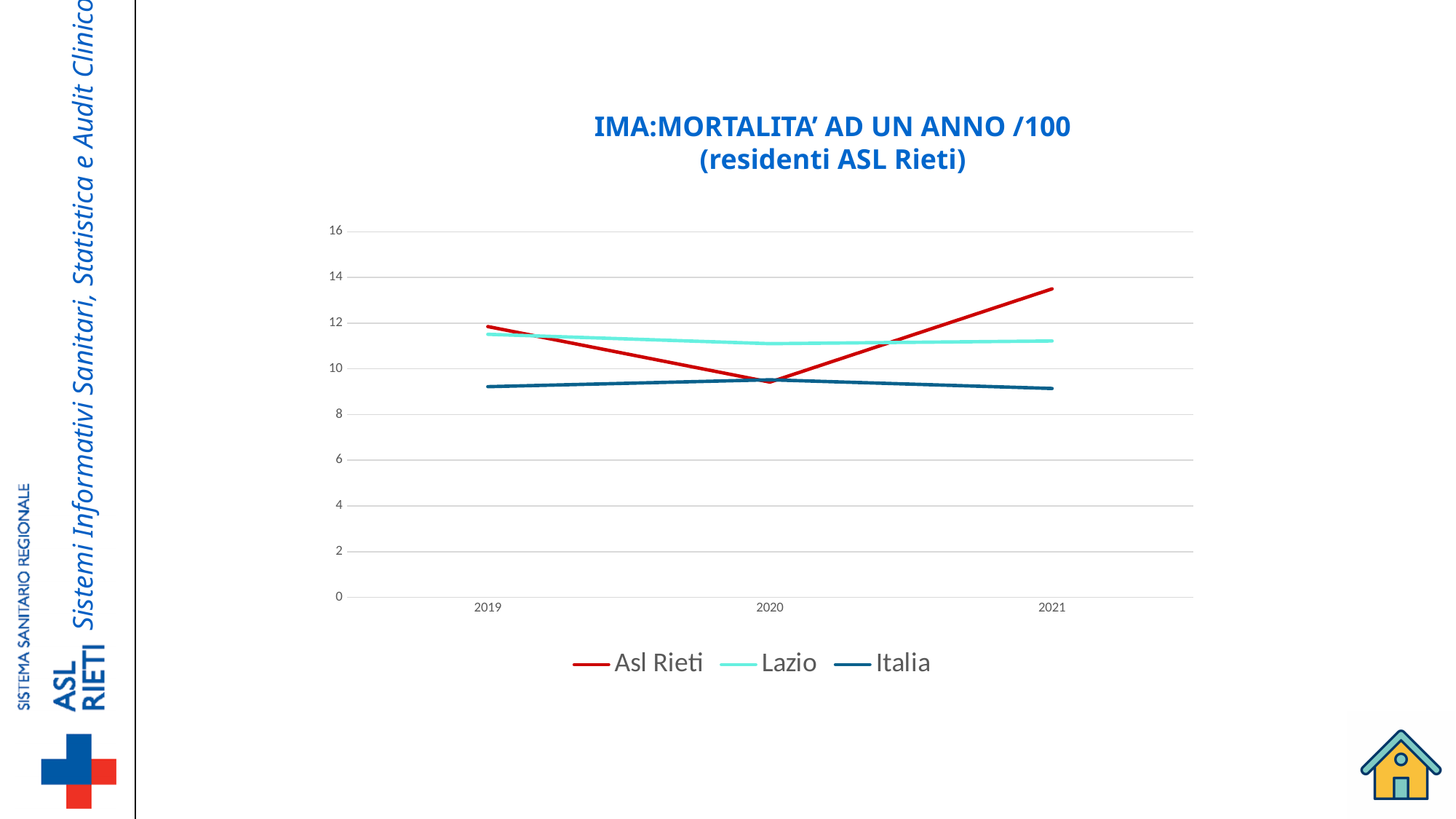
Does the Asl Rieti line rise or fall from 2020 to 2021? rise How many years are shown on the x axis? 3 In which year is the Asl Rieti value highest? 2021 Which series has the lowest value in 2021? Italia Which is larger in 2020, the value for Asl Rieti or the value for Lazio? Lazio Is the value for Asl Rieti in 2020 greater or less than 10? less Is the value for Asl Rieti in 2021 greater or less than 12? greater Which series has the highest value in 2021? Asl Rieti What is the title of the chart? IMA:MORTALITA' AD UN ANNO /100 (residenti ASL Rieti) How many series does the legend list? 3 What kind of chart is shown on the slide? line chart In which year is the Asl Rieti value lowest? 2020